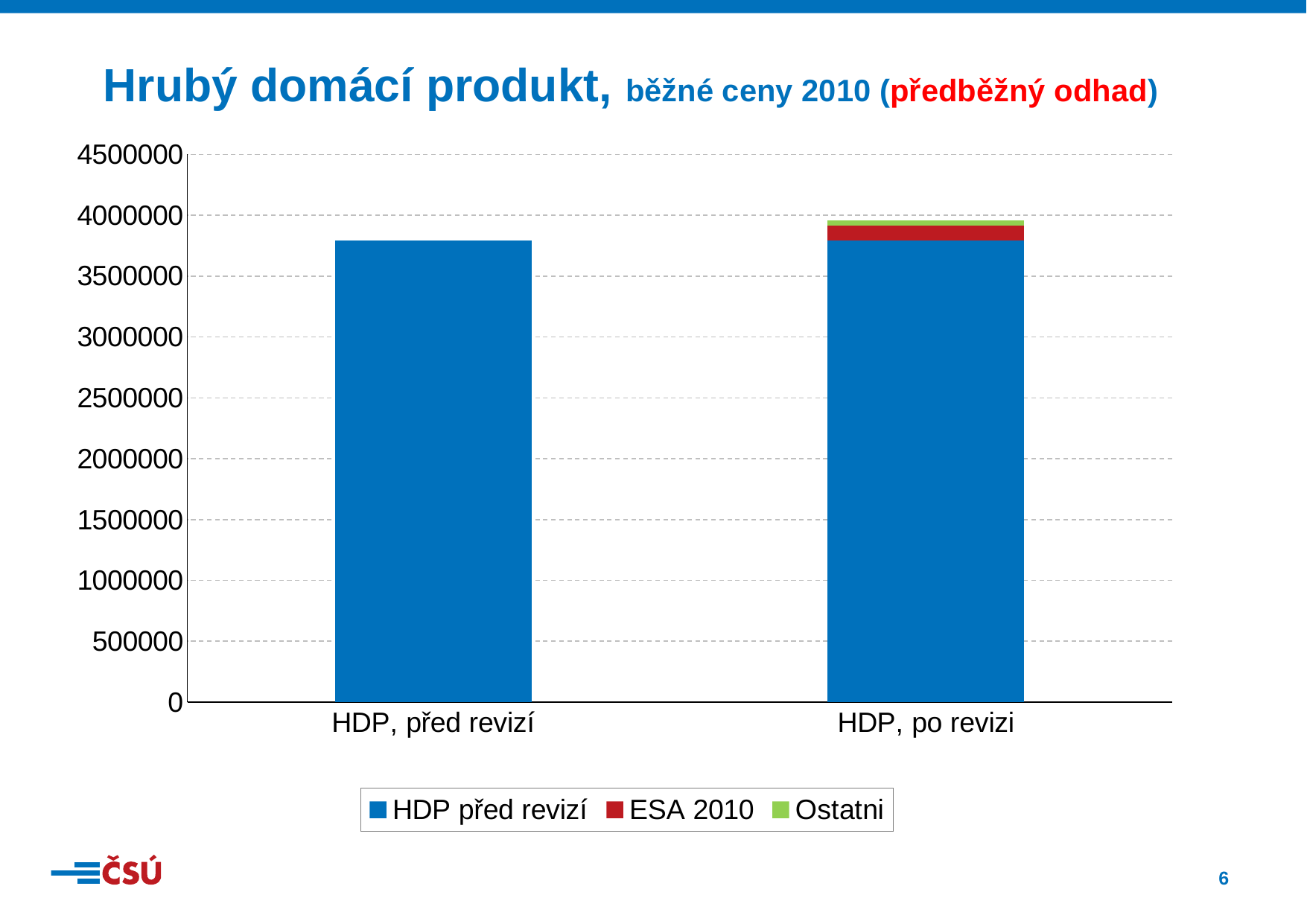
Which category has the higher total bar, HDP, před revizí or HDP, po revizi? HDP, po revizi Is the total of the HDP, po revizi bar greater or less than 4000000? less Which series is shown in red in the legend? ESA 2010 What kind of chart is shown on the slide? stacked bar chart How many series does the legend list? 3 Is the value for HDP, před revizí greater or less than 4000000? less Is the total of the HDP, po revizi bar greater or less than 3500000? greater How many categories are shown on the x axis? 2 Do the total bar values rise or fall from HDP, před revizí to HDP, po revizi? rise Which series is shown in green in the legend? Ostatni Which category has the lower total bar? HDP, před revizí